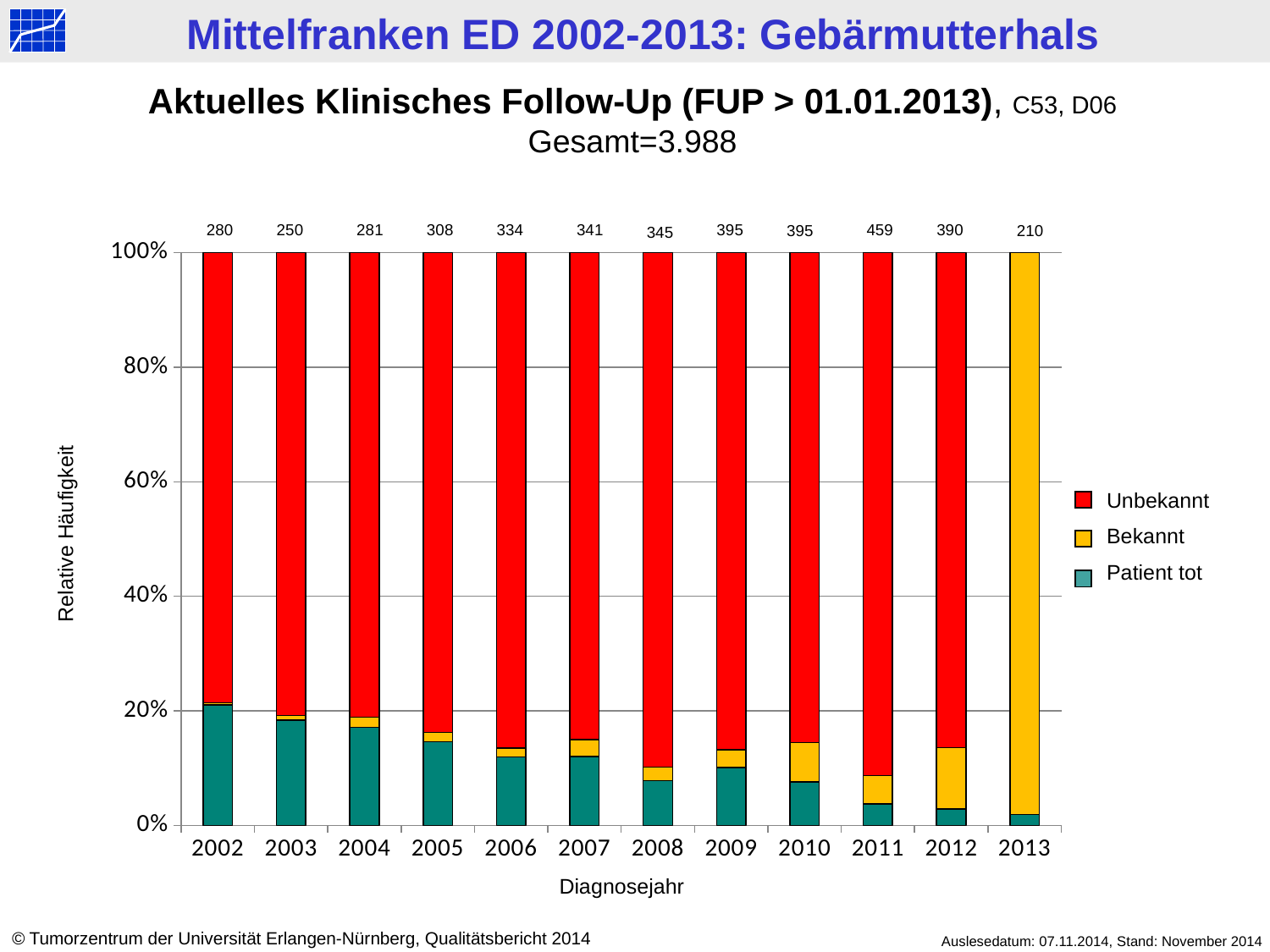
Which year has the larger number printed above its bar, 2004 or 2005? 2005 What kind of chart is shown on the slide? Stacked bar chart Is the share of 'Bekannt' in 2013 greater or less than 80%? greater Which diagnosis year has the lowest number printed above its bar? 2013 What number is printed above the bar for 2002? 280 What is the difference between the numbers printed above the bars for 2011 and 2012? 69 How many diagnosis years are shown on the x axis? 12 How many series does the legend list? 3 What number is printed above the bar for 2011? 459 What is the title of the x axis? Diagnosejahr Which diagnosis year has the highest number printed above its bar? 2011 Does the share of 'Patient tot' rise or fall from 2002 to 2013? fall